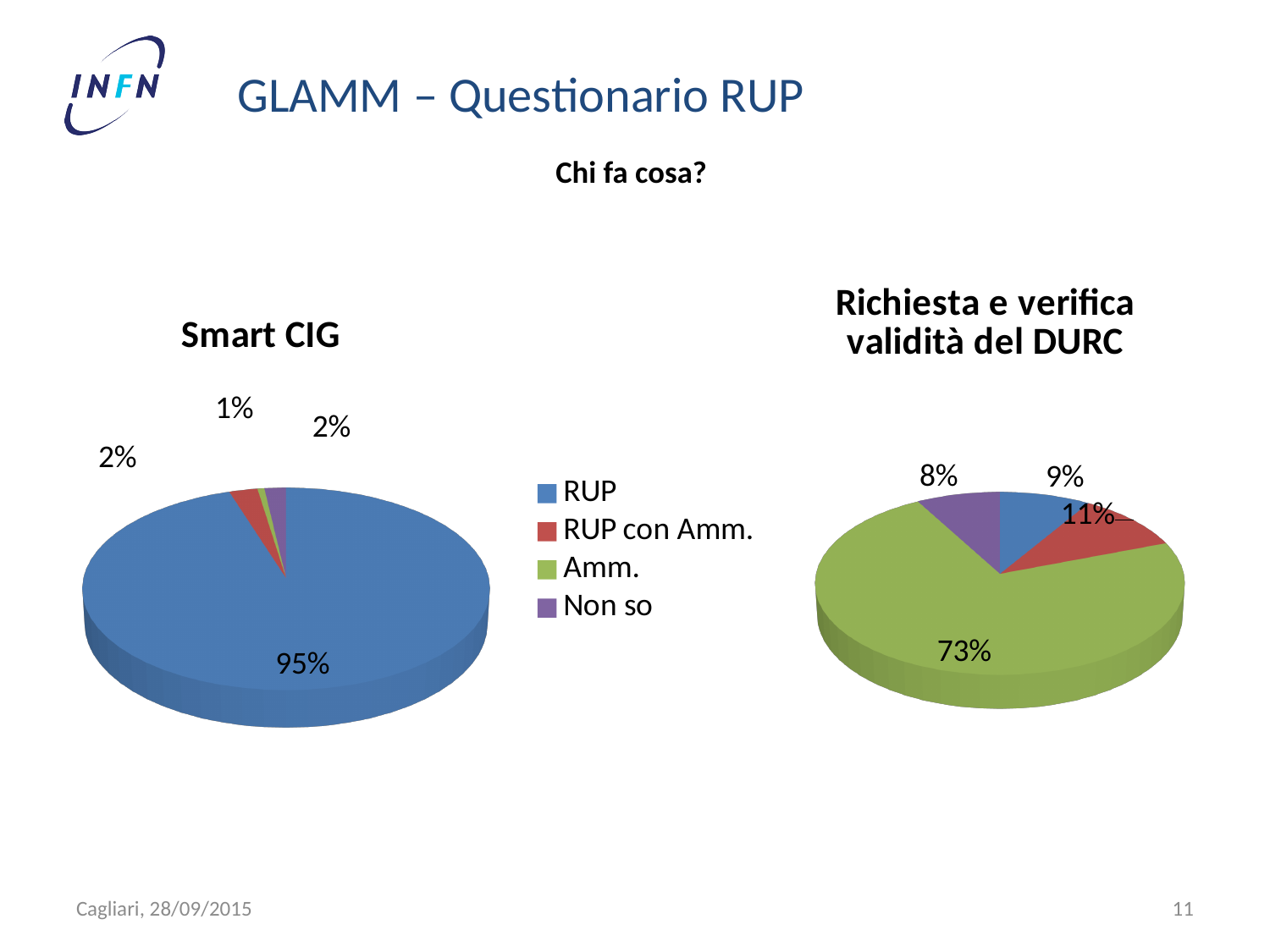
In the Smart CIG chart, what percentage is shown for RUP? 95% In the Richiesta e verifica validità del DURC chart, what percentage is shown for Non so? 8% In the Smart CIG chart, which category has the largest slice? RUP How many entries does the legend list? 4 In the Richiesta e verifica validità del DURC chart, which category has the smallest slice? Non so In the Richiesta e verifica validità del DURC chart, which category has the largest slice? Amm. In the Richiesta e verifica validità del DURC chart, which is larger, the share for RUP con Amm. or the share for RUP? RUP con Amm. In the Richiesta e verifica validità del DURC chart, what percentage is shown for RUP con Amm.? 11% In the Richiesta e verifica validità del DURC chart, what percentage is shown for RUP? 9% What is the difference between the RUP share in the Smart CIG chart and the RUP share in the Richiesta e verifica validità del DURC chart? 86% In the Richiesta e verifica validità del DURC chart, what percentage is shown for Amm.? 73% What kind of chart is the Smart CIG chart? Pie chart